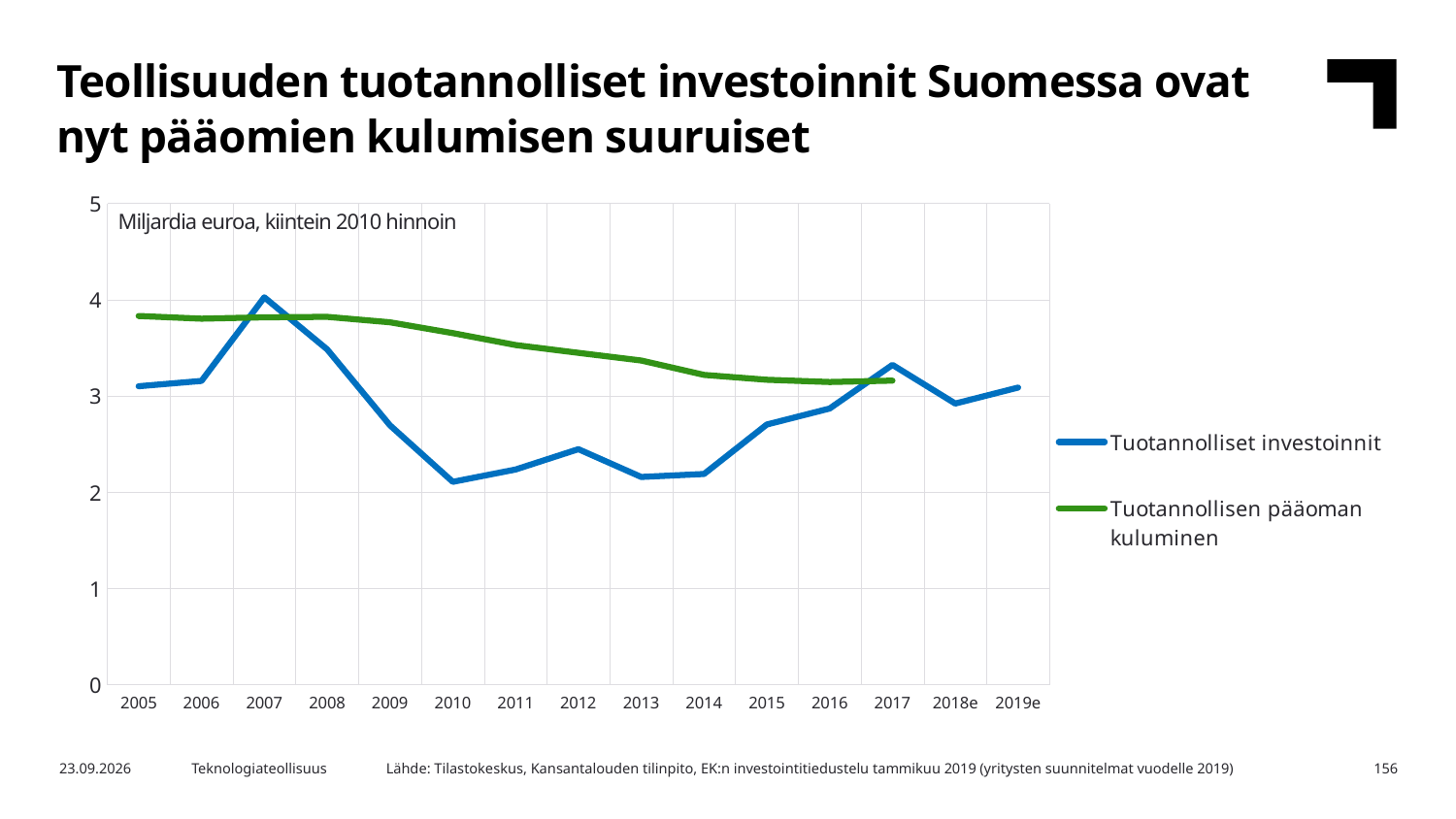
Is the value for Tuotannollisen pääoman kuluminen in 2005 greater or less than 3? greater How many years are shown on the x axis? 15 Is the value for Tuotannolliset investoinnit in 2017 greater or less than 3? greater In 2010, which series has the larger value: Tuotannolliset investoinnit or Tuotannollisen pääoman kuluminen? Tuotannollisen pääoman kuluminen How many series does the legend list? 2 What unit is stated in the text inside the chart area? Miljardia euroa, kiintein 2010 hinnoin Does the Tuotannollisen pääoman kuluminen series rise or fall from 2005 to 2017? fall In which year does the Tuotannolliset investoinnit series reach its highest value? 2007 Is the value for Tuotannolliset investoinnit in 2009 greater or less than 3? less Which colour is used for the Tuotannolliset investoinnit series? blue What kind of chart is shown on the slide? line chart